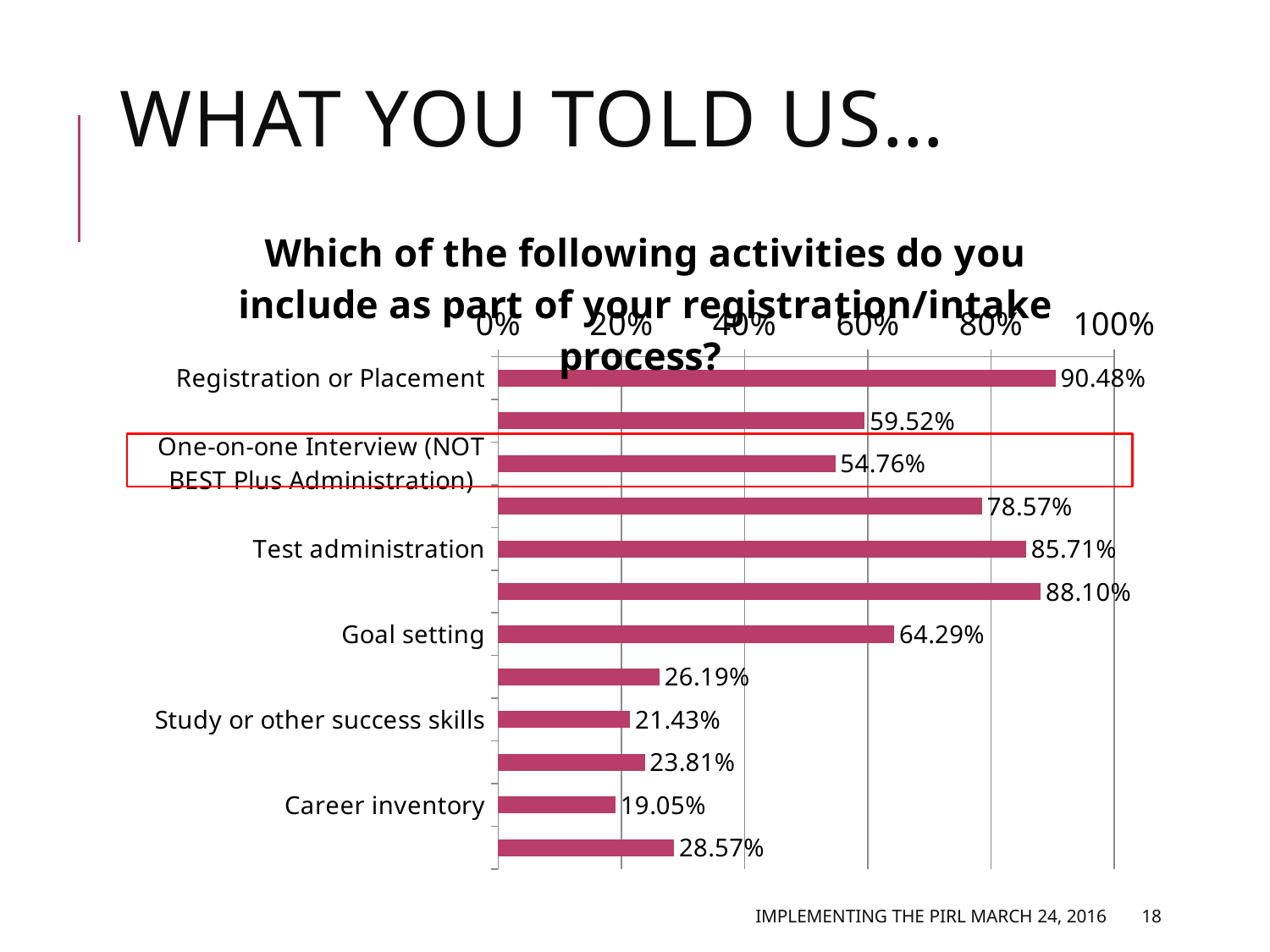
What percentage is shown for Test administration? 85.71% What percentage is shown for Registration or Placement? 90.48% What is the value for Goal setting? 64.29% How many bars are plotted in the chart? 12 What kind of chart is shown on the slide? Bar chart What percentage is shown for Career inventory? 19.05% Which activity has the highest percentage? Registration or Placement Which activity has the lowest percentage? Career inventory Is the value for Study or other success skills greater or less than 40%? less What is the difference between the values for Registration or Placement and Test administration? 4.77 percentage points What is the value for One-on-one Interview (NOT BEST Plus Administration)? 54.76% Which is larger, the value for Goal setting or the value for One-on-one Interview (NOT BEST Plus Administration)? Goal setting